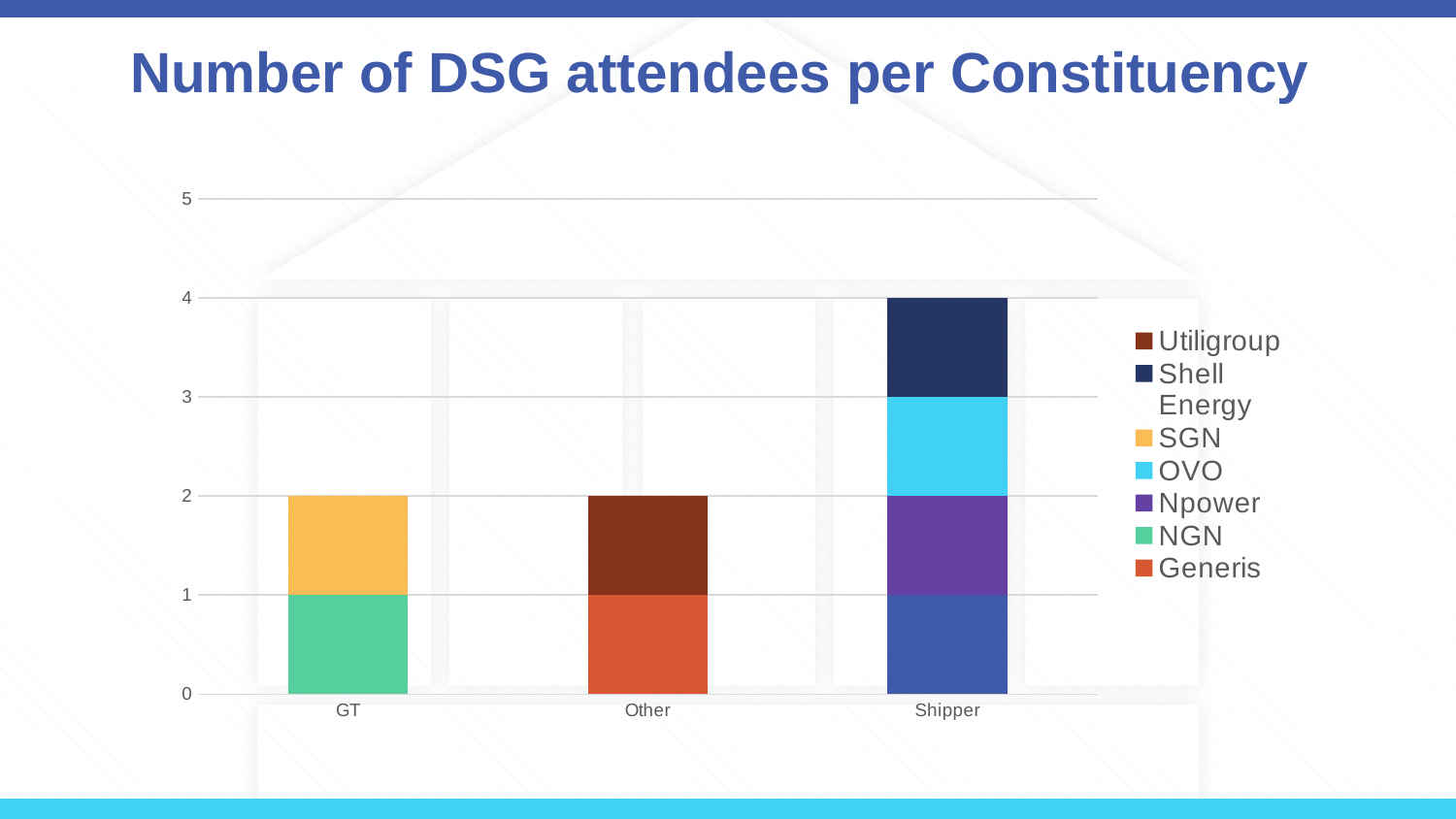
Is the total for Shipper greater or less than 3? greater Which bar is taller, GT or Shipper? Shipper What is the value of the SGN segment in the GT bar? 1 What is the total height of the Shipper bar? 4 Is the total for Other greater or less than 3? less How many constituencies are shown on the x axis? 3 Which constituency has the highest total number of DSG attendees? Shipper What is the total height of the GT bar? 2 How many series does the legend list? 7 What is the title of the chart? Number of DSG attendees per Constituency What is the difference between the total for Shipper and the total for GT? 2 What kind of chart is shown on the slide? Stacked bar chart